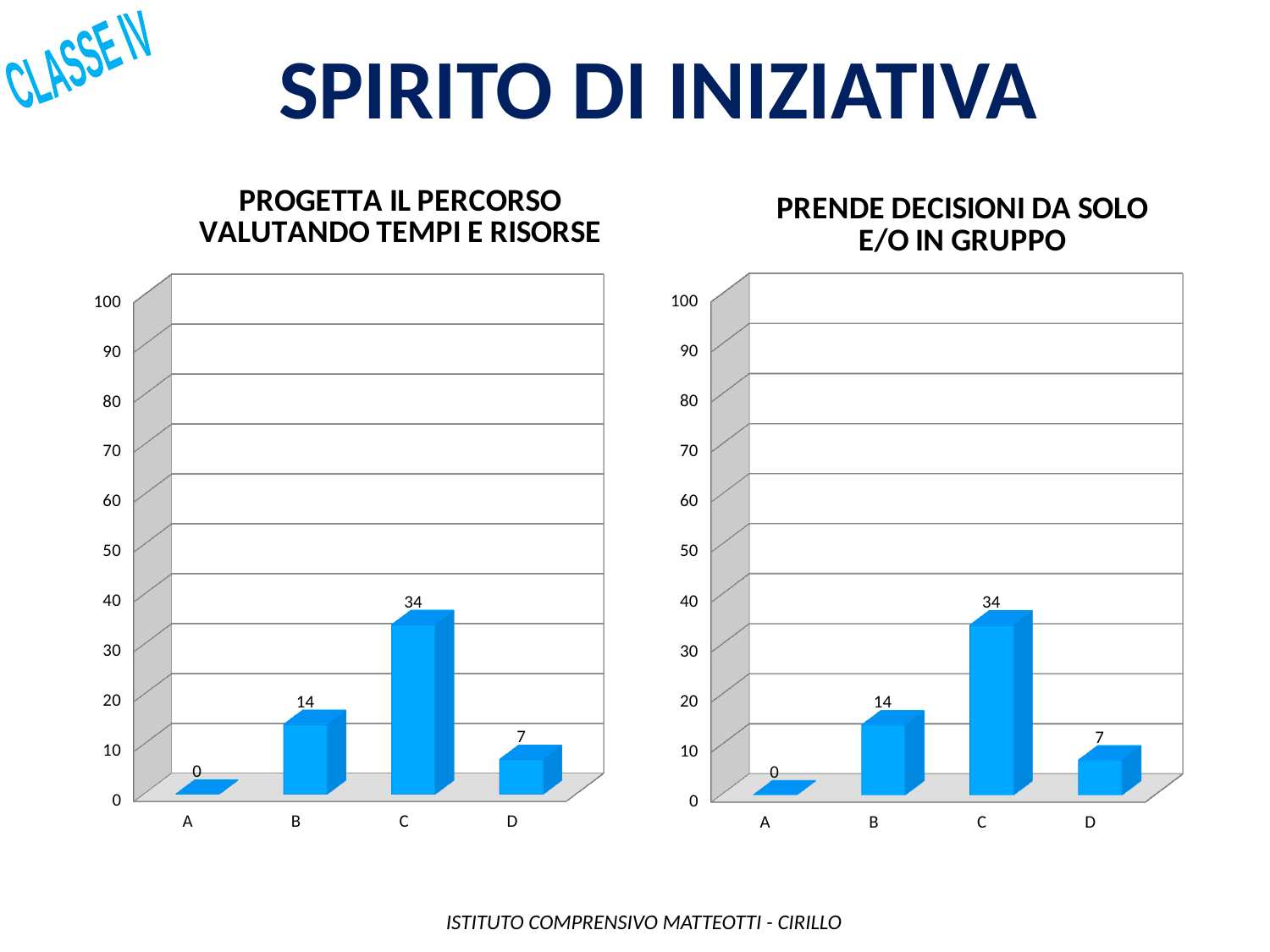
In the left chart, what is the value for category A? 0 How many categories are shown on the x axis of the left chart? 4 In the left chart, is the value for C greater or less than 50? less In the chart titled 'PRENDE DECISIONI DA SOLO E/O IN GRUPPO', which is larger, the value for B or the value for D? B What is the title of the chart on the right side of the slide? PRENDE DECISIONI DA SOLO E/O IN GRUPPO What kind of chart is the chart titled 'PRENDE DECISIONI DA SOLO E/O IN GRUPPO'? bar chart In the chart titled 'PROGETTA IL PERCORSO VALUTANDO TEMPI E RISORSE', what is the value for category C? 34 In the chart titled 'PROGETTA IL PERCORSO VALUTANDO TEMPI E RISORSE', what is the difference between the values for C and B? 20 In the left chart, which category has the lowest value? A In the right chart, what is the difference between the values for B and D? 7 In the chart titled 'PRENDE DECISIONI DA SOLO E/O IN GRUPPO', what is the value for category B? 14 In the right chart, which category has the highest value? C